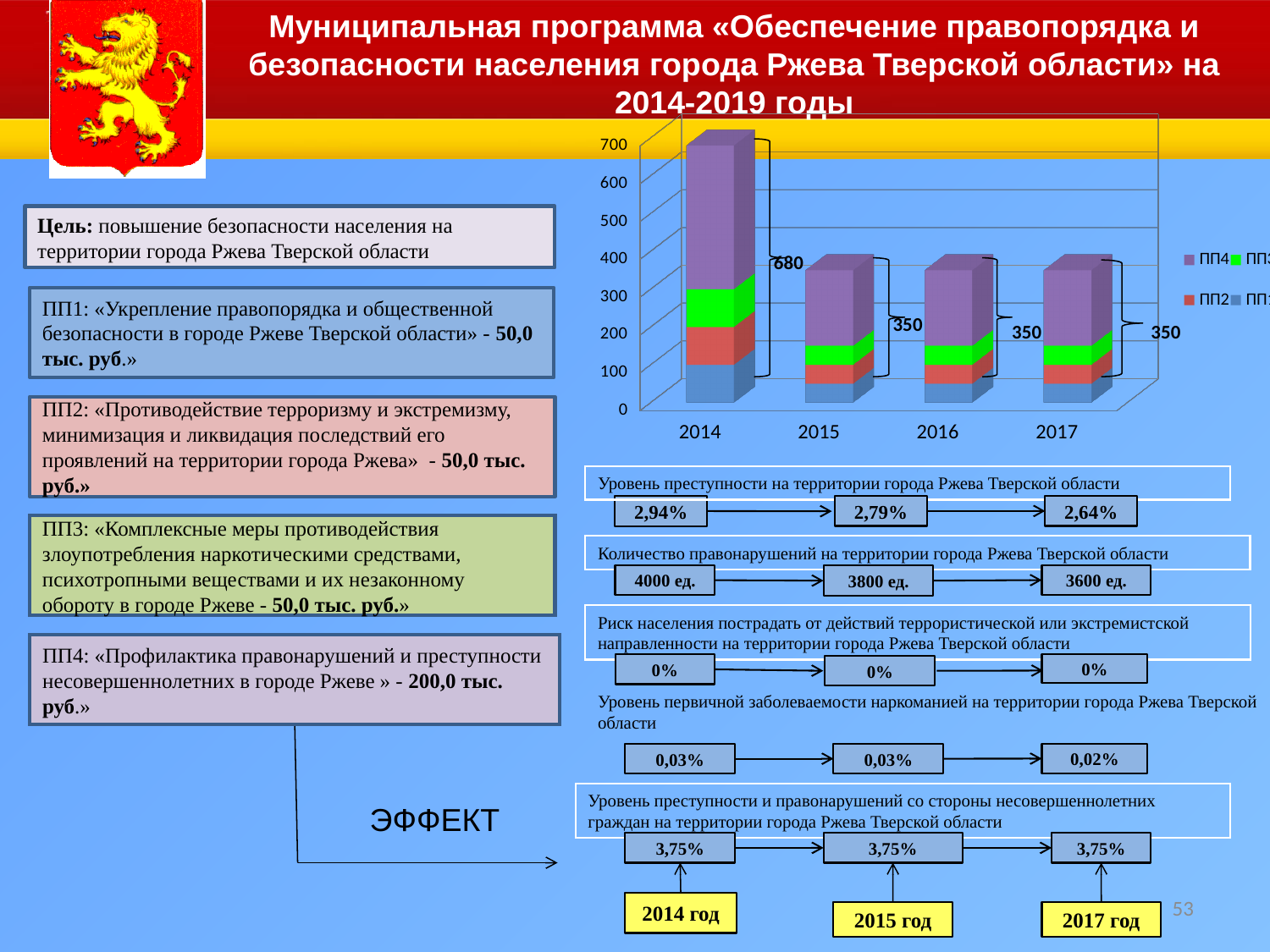
What is the total value of the stacked bar for 2017? 350 What colour is the ПП4 series in the chart? purple What is the first year shown on the x axis of the chart? 2014 Do the bar totals rise or fall from 2014 to 2015? fall What is the total value of the stacked bar for 2015? 350 What kind of chart is shown on the slide? stacked bar chart Which is larger, the total for 2014 or the total for 2017? 2014 How many years are shown on the x axis of the chart? 4 How many entries does the chart legend list? 4 What is the total value of the stacked bar for 2014? 680 What is the difference between the total for 2014 and the total for 2016? 330 Which year has the highest total in the chart? 2014